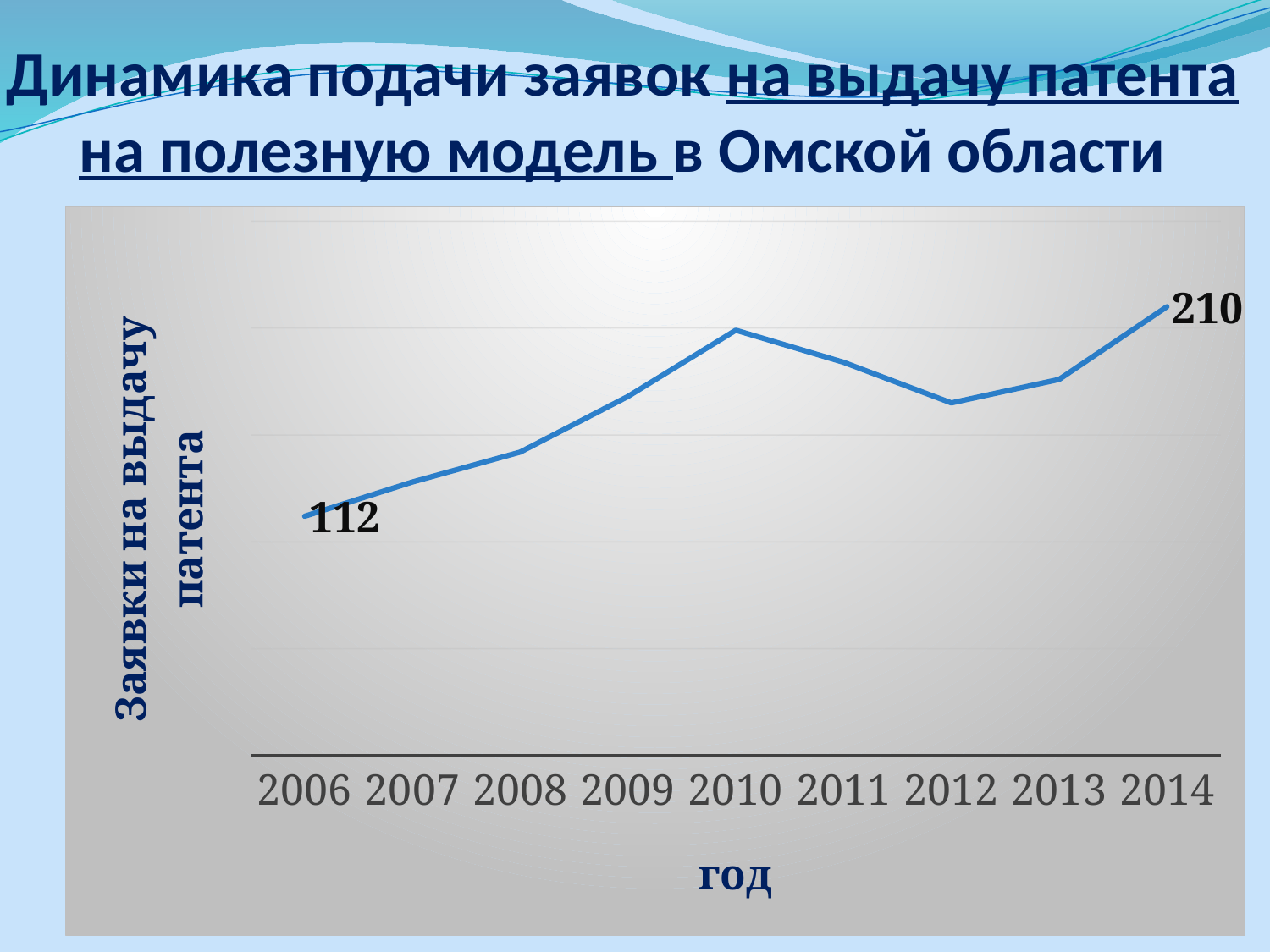
Which year has the lowest value? 2006 What is the value for 2014? 210 Which year has the larger value, 2008 or 2009? 2009 What is the value for 2006? 112 What is the title of the x axis? год Overall, do the values rise or fall from 2006 to 2014? rise Which year has the highest value? 2014 How many years are plotted on the x axis? 9 Which year has the larger value, 2010 or 2012? 2010 Which year has the larger value, 2011 or 2013? 2011 What type of chart is shown on the slide? line chart What is the difference between the values for 2014 and 2006? 98